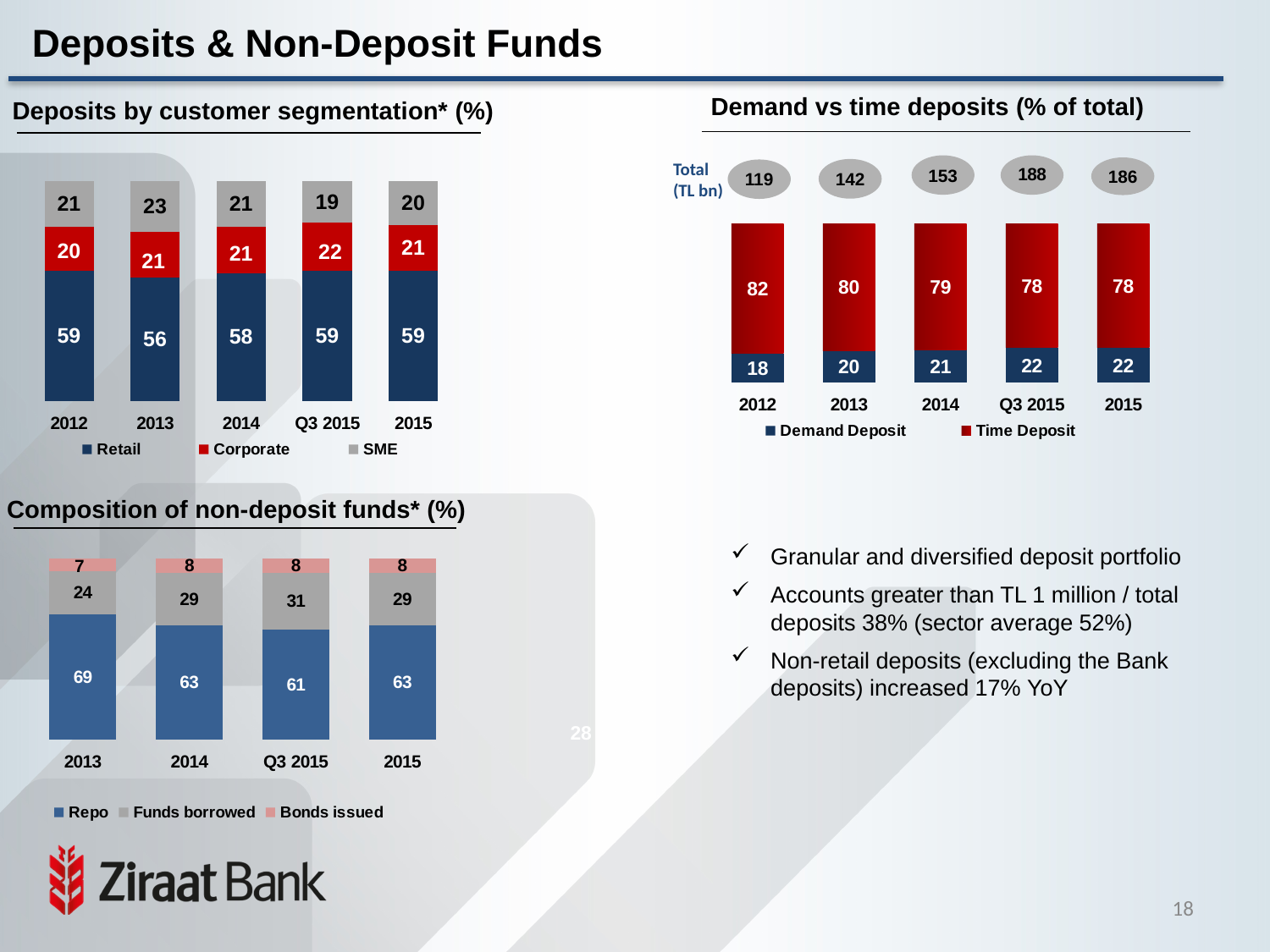
In the 'Deposits by customer segmentation' chart, what is the Retail value for 2013? 56 In the 'Demand vs time deposits' chart, what is the Demand Deposit value for 2012? 18 What kind of chart is the 'Composition of non-deposit funds' chart? stacked bar chart In the 'Demand vs time deposits' chart, what is the total (TL bn) shown for Q3 2015? 188 In the 'Demand vs time deposits' chart, does the Demand Deposit share rise or fall from 2012 to 2015? rise In the 'Composition of non-deposit funds' chart, what is the Repo value for Q3 2015? 61 In the 'Demand vs time deposits' chart, what is the difference between the Time Deposit values for 2012 and 2015? 4 In the 'Composition of non-deposit funds' chart, which year has the lowest Funds borrowed value? 2013 In the 'Composition of non-deposit funds' chart, how many periods are shown on the x axis? 4 In the 'Deposits by customer segmentation' chart, which year has the highest SME share? 2013 In the 'Deposits by customer segmentation' chart, what is the SME value for Q3 2015? 19 In the 'Deposits by customer segmentation' chart, how many series does the legend list? 3